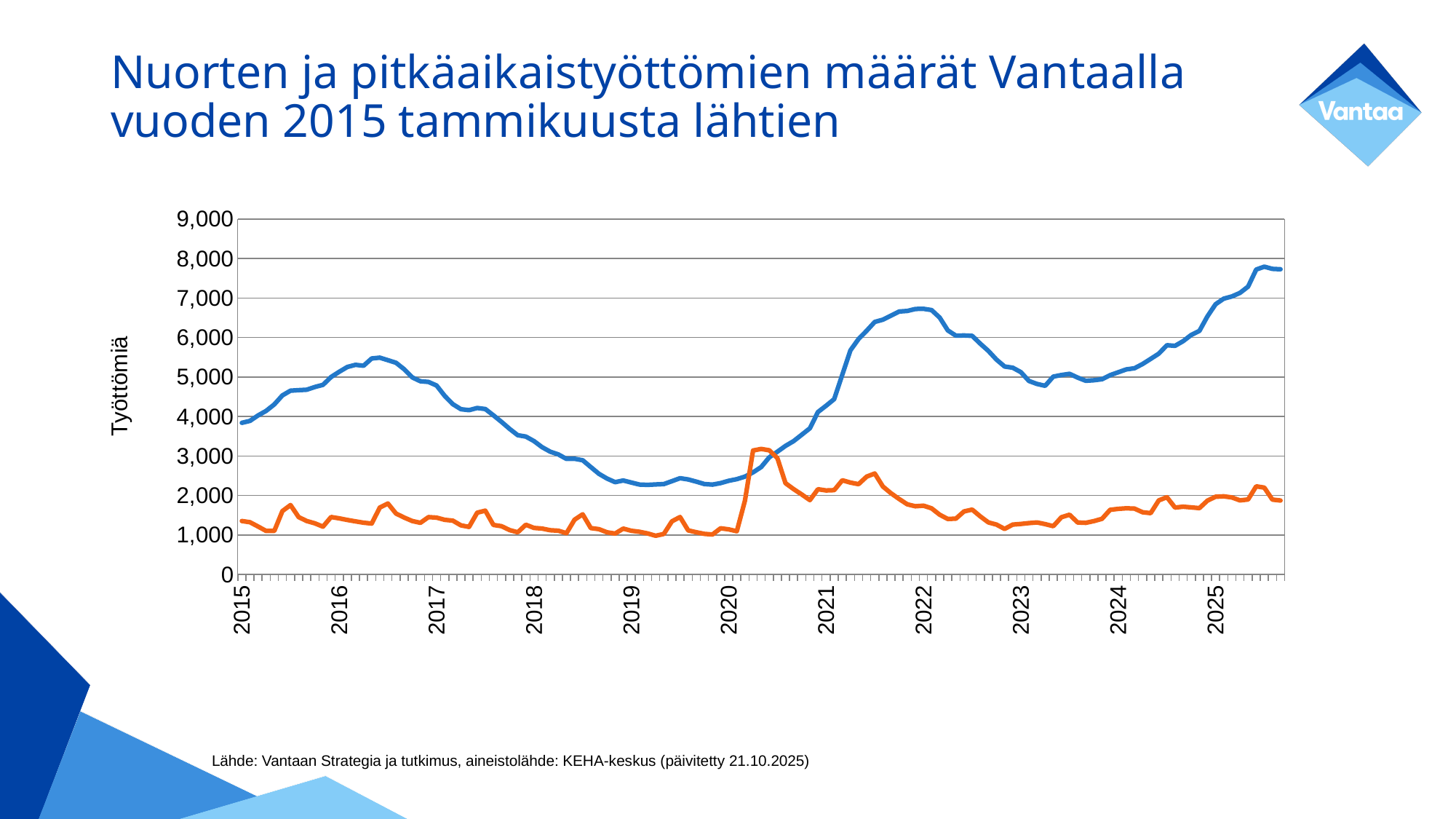
What is the first year shown on the horizontal axis? 2015 Is the value of the orange line at the start of 2023 greater or less than 2,000? less How many lines are plotted on the chart? 2 What is the label of the vertical axis? Työttömiä Is the value of the blue line at the start of 2019 greater or less than 3,000? less Does the blue line rise or fall between 2016 and 2019? fall What kind of chart is shown on the slide? line chart Is the value of the orange line at its peak in 2020 greater or less than 3,000? greater In which year does the blue line reach its highest value? 2025 Which line has the higher value at the end of the series in 2025, the blue line or the orange line? the blue line